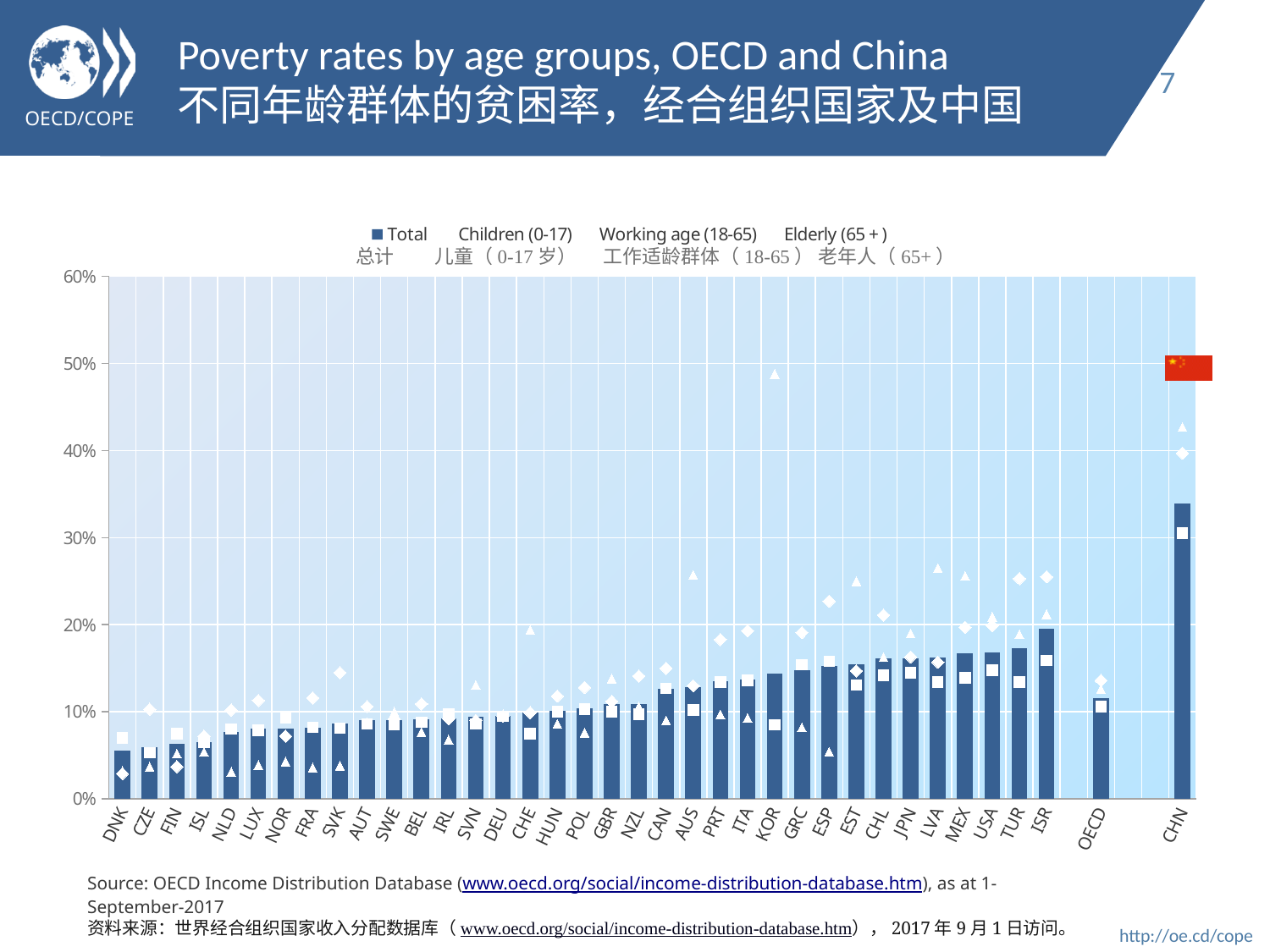
How many series does the legend list? 4 How many countries or groups are shown along the x axis? 37 What type of chart is shown on the slide? combination bar and line chart (bars with markers) Which has the higher Total poverty rate, ISR or DNK? ISR Which has the higher Total poverty rate, CHN or OECD? CHN Which country has the lowest Total poverty rate bar? DNK Is the Total poverty rate for DNK greater or less than 10%? less Is the Elderly (65+) poverty rate for KOR greater or less than 40%? greater Which series in the legend is plotted as bars? Total Is the Total poverty rate for CHN greater or less than 30%? greater Do the Total poverty rate bars generally rise or fall from DNK to ISR along the x axis? rise Which country or group has the highest Total poverty rate bar? CHN